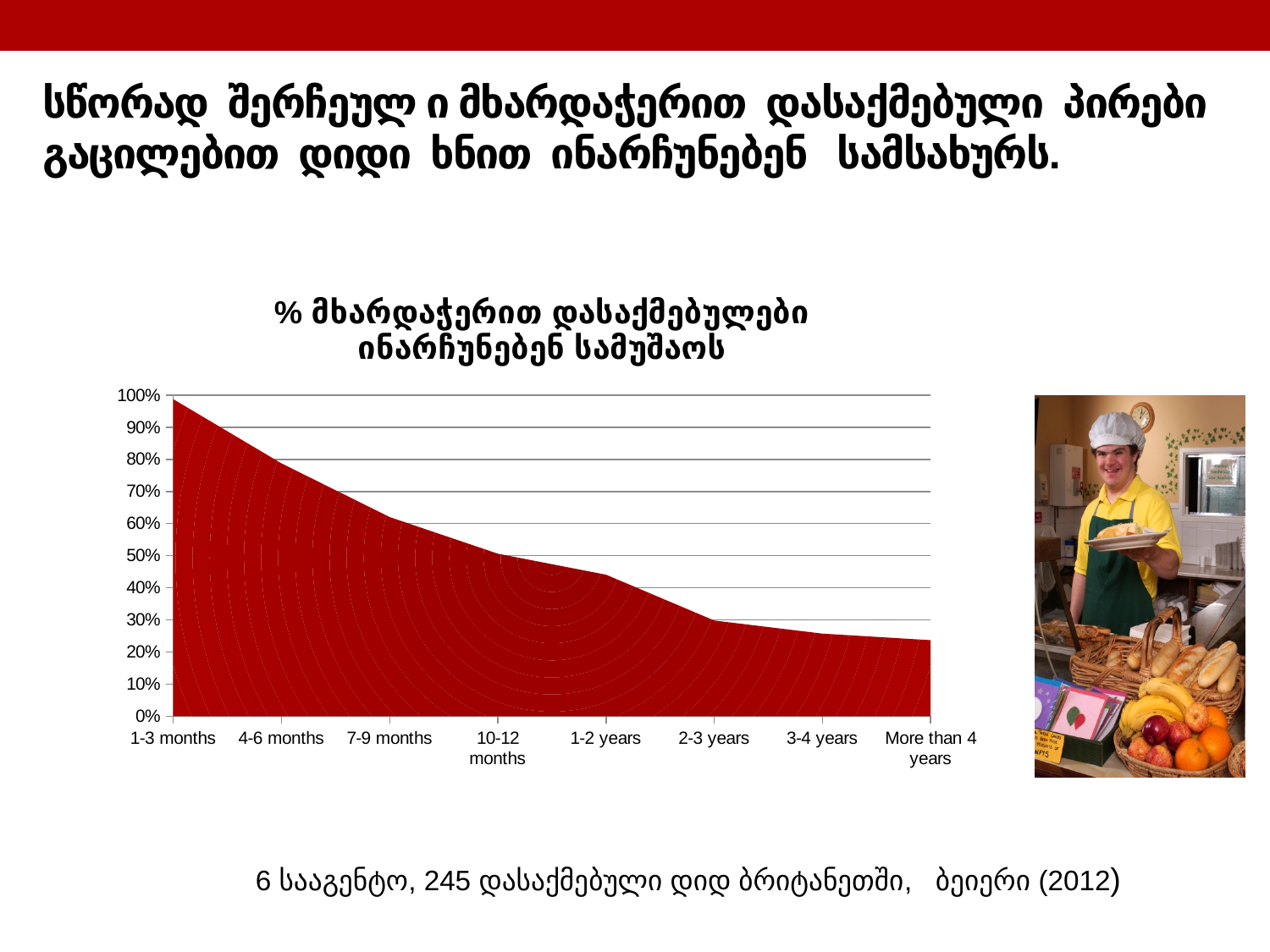
Do the values rise or fall as you move from 1-3 months to More than 4 years along the x axis? fall Which is larger, the value for 4-6 months or the value for 2-3 years? 4-6 months What kind of chart is shown on the slide? area chart How many categories are shown along the x axis of the chart? 8 Is the value for 1-2 years greater or less than 50%? less What is the last category label on the x axis of the chart? More than 4 years Is the value for 7-9 months greater or less than 70%? less What is the first category label on the x axis of the chart? 1-3 months Is the value for 1-3 months greater or less than 90%? greater Which category has the highest value in the chart? 1-3 months